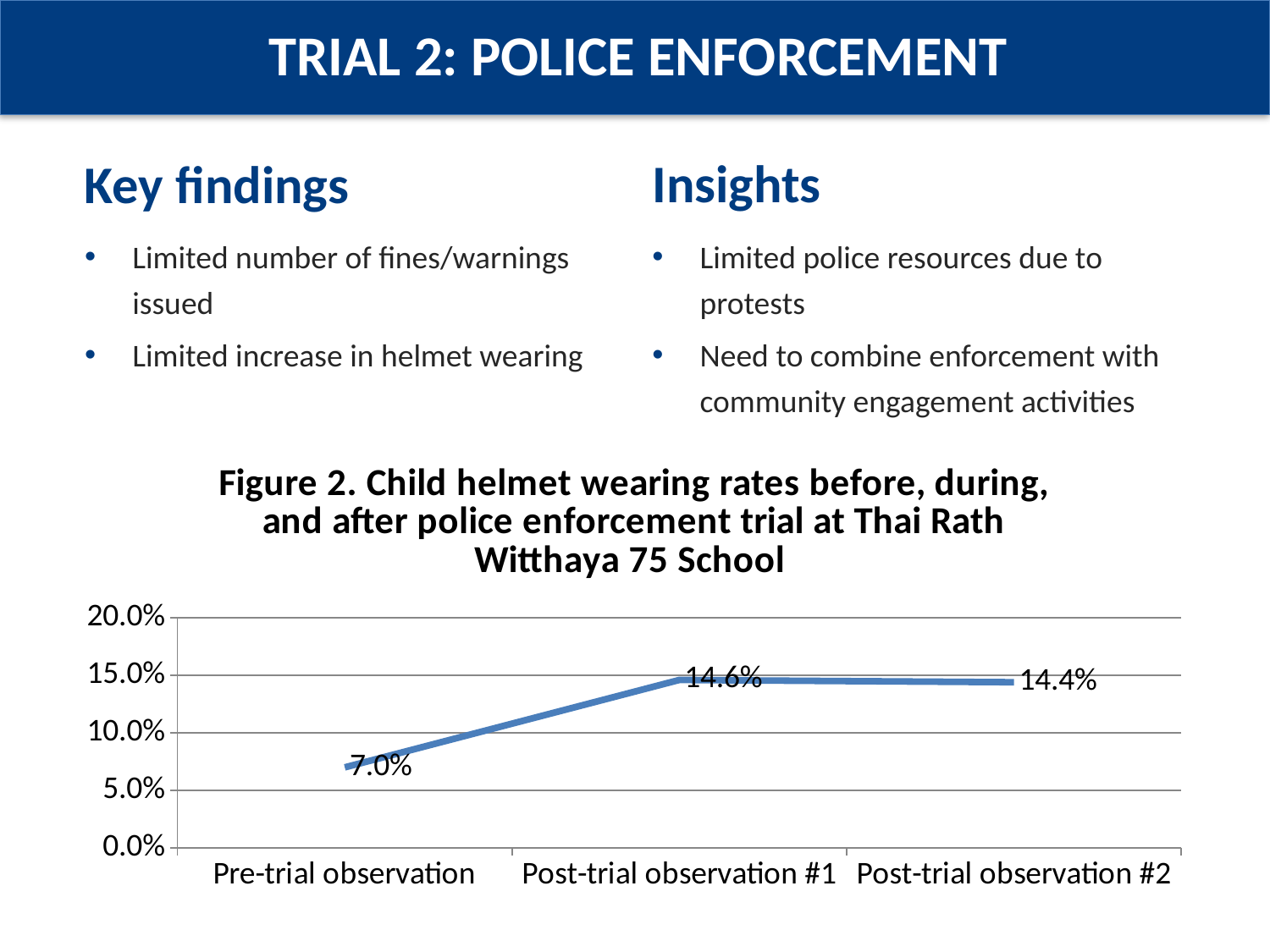
What is the difference in helmet wearing rate between Post-trial observation #1 and Post-trial observation #2? 0.2% What is the child helmet wearing rate at Post-trial observation #2? 14.4% Which observation has the lowest helmet wearing rate? Pre-trial observation What is the child helmet wearing rate at the Pre-trial observation? 7.0% What is the child helmet wearing rate at Post-trial observation #1? 14.6% Which is larger, the helmet wearing rate at the Pre-trial observation or at Post-trial observation #2? Post-trial observation #2 What type of chart is shown on the slide? Line chart What is the difference in helmet wearing rate between Post-trial observation #1 and the Pre-trial observation? 7.6% What is the title of the chart on the slide? Figure 2. Child helmet wearing rates before, during, and after police enforcement trial at Thai Rath Witthaya 75 School Is the helmet wearing rate at the Pre-trial observation greater or less than 10.0%? less How many observation points are plotted on the chart? 3 Which observation has the highest helmet wearing rate? Post-trial observation #1